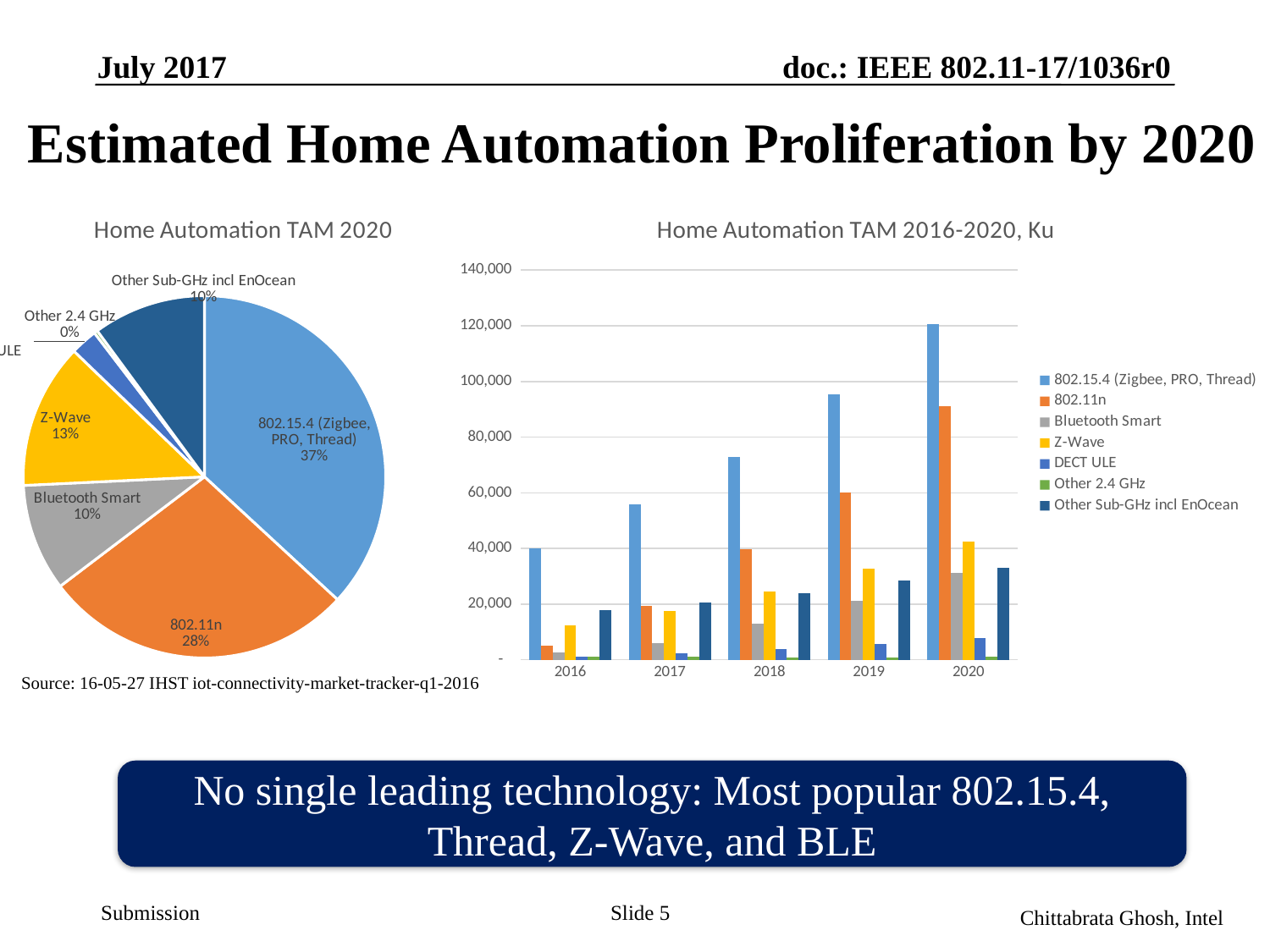
In the Home Automation TAM 2020 pie chart, how many percentage points larger is the 802.15.4 (Zigbee, PRO, Thread) share than the 802.11n share? 9 percentage points In the Home Automation TAM 2020 pie chart, what share does Other 2.4 GHz have? 0% How many years are shown on the x axis of the Home Automation TAM 2016-2020, Ku chart? 5 In the Home Automation TAM 2020 pie chart, what share does Bluetooth Smart have? 10% In the Home Automation TAM 2016-2020, Ku chart, which is larger in 2018: 802.15.4 (Zigbee, PRO, Thread) or 802.11n? 802.15.4 (Zigbee, PRO, Thread) In the Home Automation TAM 2020 pie chart, what share does 802.11n have? 28% What kind of chart is the Home Automation TAM 2016-2020, Ku chart? Bar chart In the Home Automation TAM 2020 pie chart, which technology has the largest slice? 802.15.4 (Zigbee, PRO, Thread) In the Home Automation TAM 2016-2020, Ku chart, does the value for 802.15.4 (Zigbee, PRO, Thread) rise or fall from 2016 to 2020? Rises How many series does the legend of the Home Automation TAM 2016-2020, Ku chart list? 7 In the Home Automation TAM 2016-2020, Ku chart, is the value for 802.15.4 (Zigbee, PRO, Thread) in 2020 greater or less than 100,000? greater